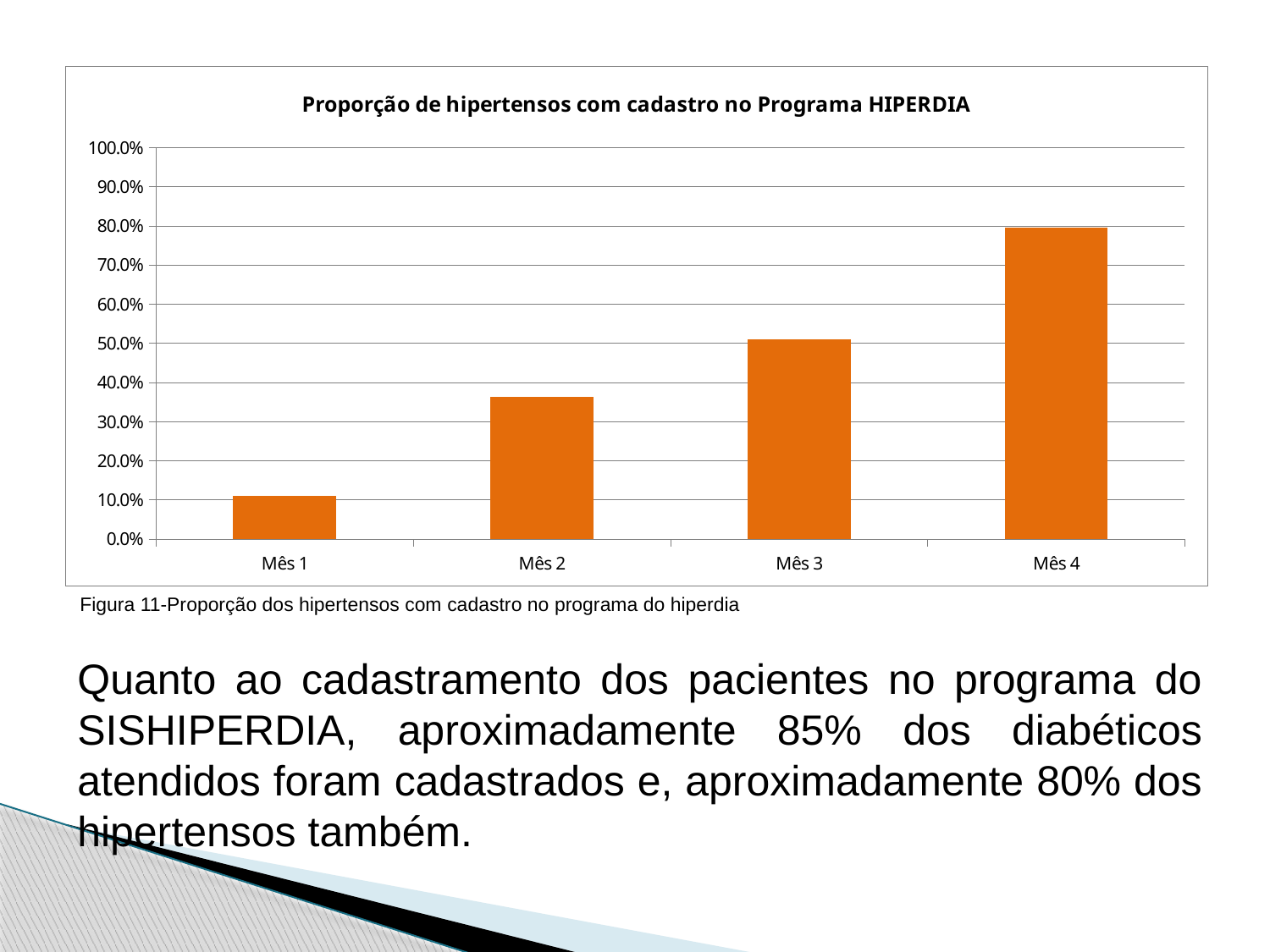
Which is larger, the value for Mês 2 or the value for Mês 3? Mês 3 What kind of chart is shown on the slide? bar chart Is the value for Mês 1 greater or less than 20.0%? less Do the values rise or fall from Mês 1 to Mês 4? rise Is the value for Mês 2 greater or less than 30.0%? greater Which month has the highest proportion? Mês 4 What is the title of the chart? Proporção de hipertensos com cadastro no Programa HIPERDIA What is the maximum value shown on the y axis? 100.0% Which month has the lowest proportion? Mês 1 Is the value for Mês 4 greater or less than 70.0%? greater How many categories (months) are plotted on the x axis? 4